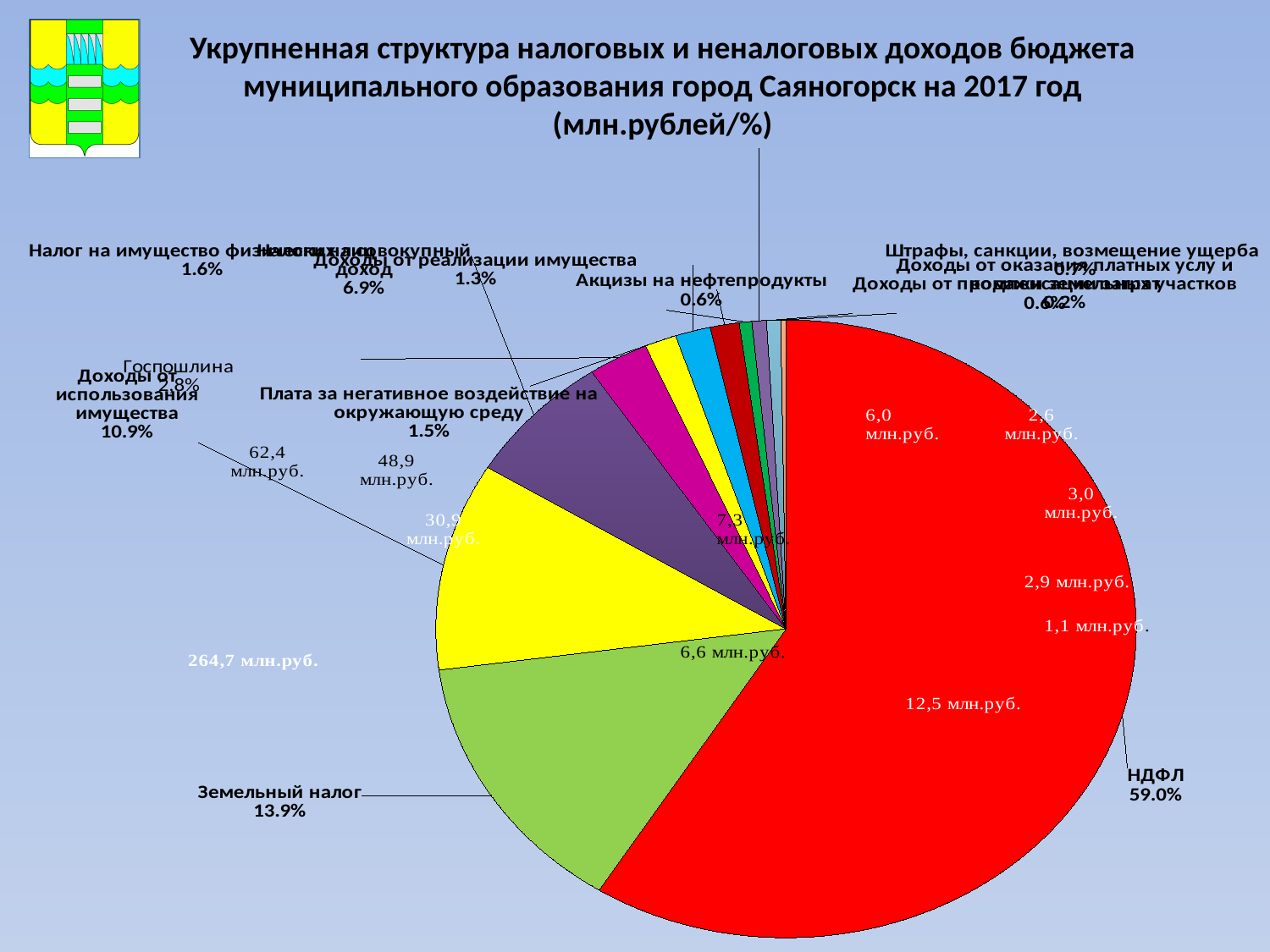
What percentage is shown for Земельный налог? 13.9% What percentage is shown for Доходы от использования имущества? 10.9% What percentage is shown for Госпошлина? 2.8% What is the difference in percentage points between НДФЛ and Земельный налог? 45.1 What share of the pie does НДФЛ account for? 59.0% What percentage is shown for Доходы от реализации имущества? 1.3% What percentage is shown for Плата за негативное воздействие на окружающую среду? 1.5% Which category has the largest slice of the pie? НДФЛ What colour is the НДФЛ slice? Red Which is larger: Земельный налог or Доходы от использования имущества? Земельный налог What kind of chart is shown on the slide? Pie chart What percentage is shown for Акцизы на нефтепродукты? 0.6%